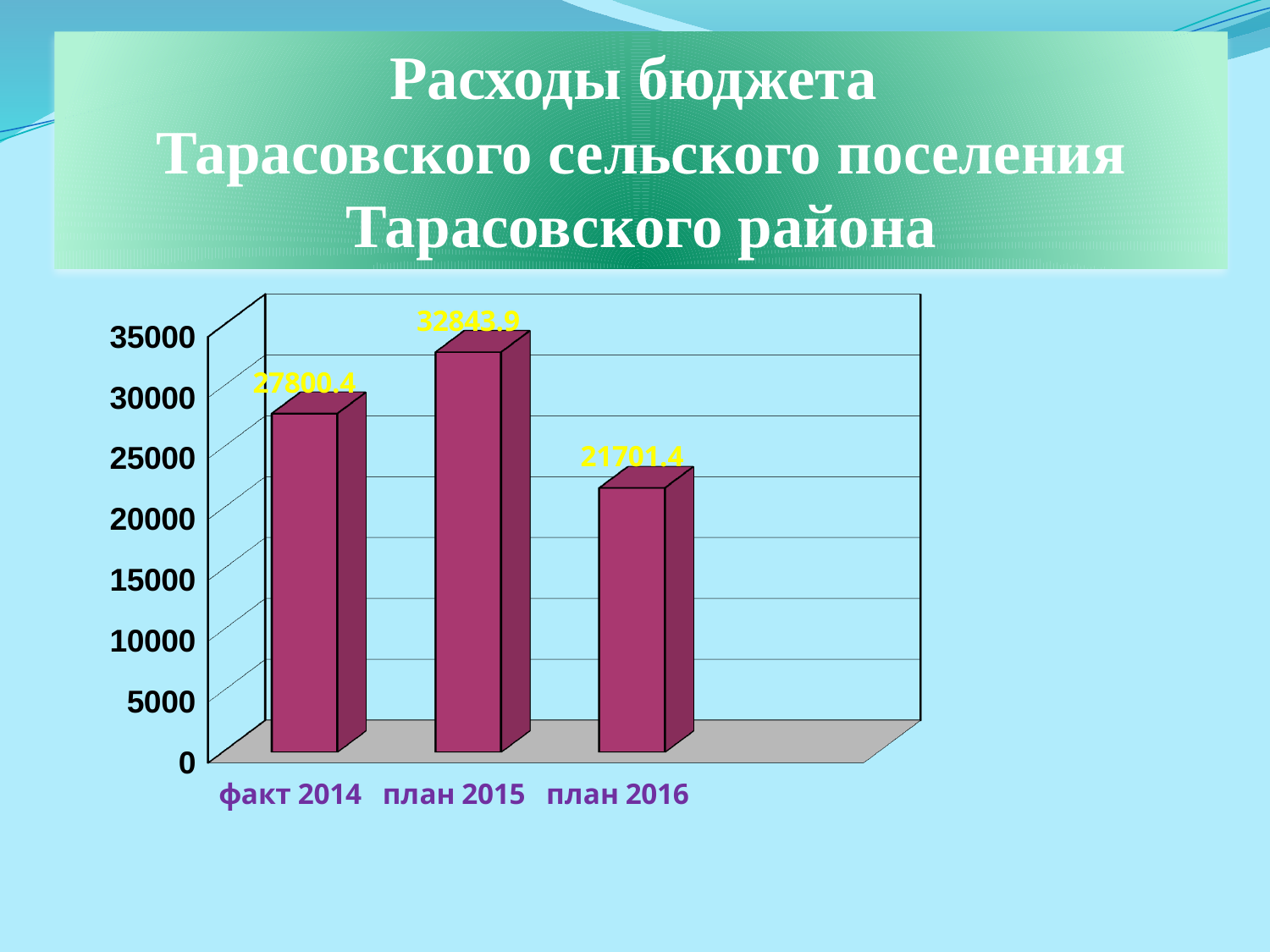
Do the values rise or fall from план 2015 to план 2016? fall What is the difference between the values for план 2015 and факт 2014? 5043.5 How many categories are shown on the x axis? 3 Is the value for план 2016 greater or less than 20000? greater What kind of chart is shown on the slide? bar chart Which category has the lowest value? план 2016 Which category has the highest value? план 2015 Which is larger, the value for факт 2014 or the value for план 2016? факт 2014 What is the value for план 2015? 32843.9 What is the value for план 2016? 21701.4 What is the value for факт 2014? 27800.4 What is the difference between the values for план 2015 and план 2016? 11142.5